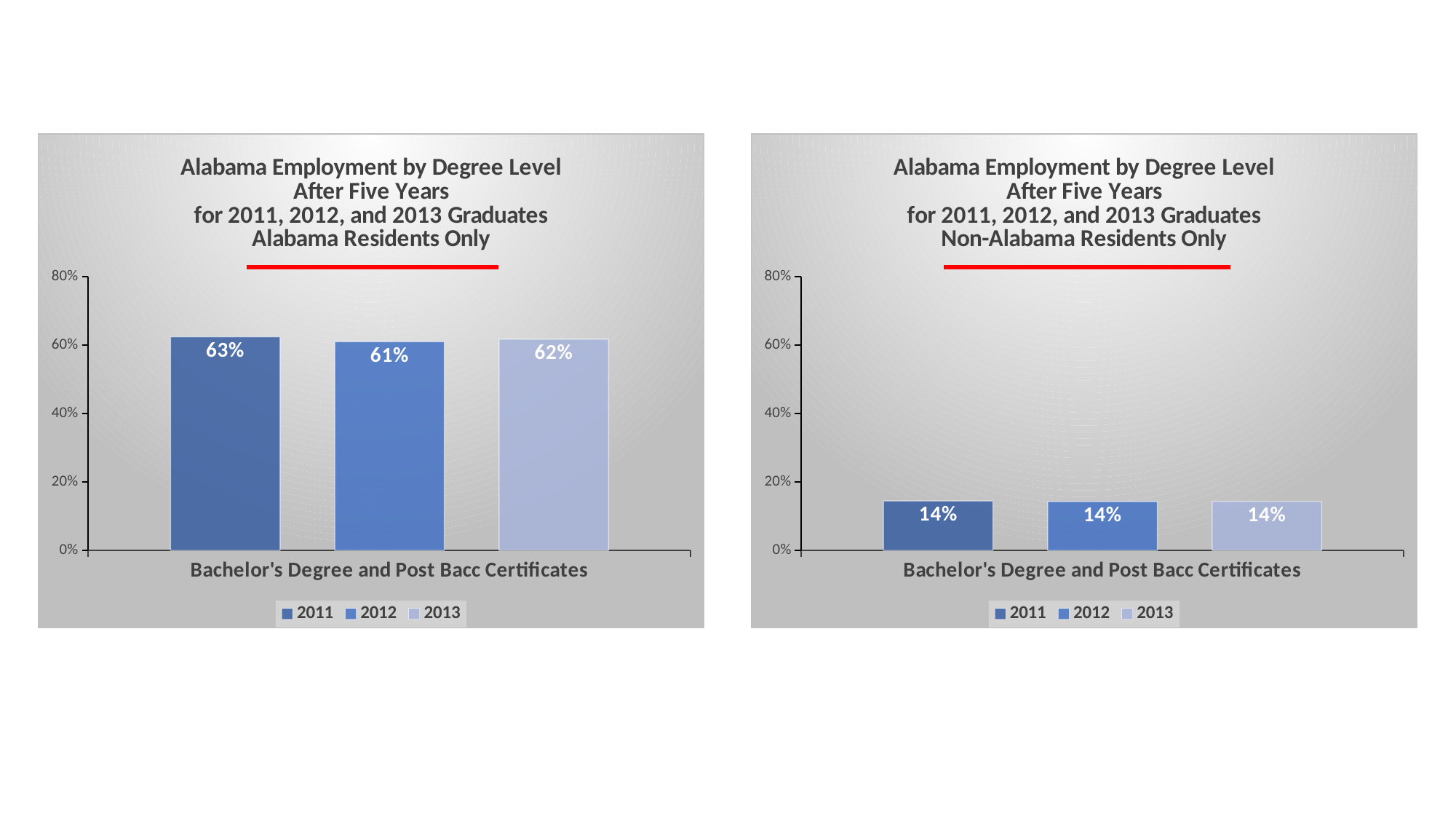
In the left chart (Alabama Residents Only), what is the value for 2012? 61% In the left chart (Alabama Residents Only), what is the value for 2011? 63% In the left chart (Alabama Residents Only), what is the value for 2013? 62% In the left chart (Alabama Residents Only), which year has the highest value? 2011 In the left chart (Alabama Residents Only), what is the difference between the 2011 and 2012 values? 2% In the right chart (Non-Alabama Residents Only), what is the value for 2012? 14% In the right chart (Non-Alabama Residents Only), is the value for 2011 greater or less than 20%? less How many series does the legend of the right chart (Non-Alabama Residents Only) list? 3 In the left chart (Alabama Residents Only), is the value for 2013 greater or less than 60%? greater In the left chart (Alabama Residents Only), which year has the lowest value? 2012 What kind of chart is the left chart (Alabama Residents Only)? Bar chart What is the x-axis category label shown on the right chart (Non-Alabama Residents Only)? Bachelor's Degree and Post Bacc Certificates